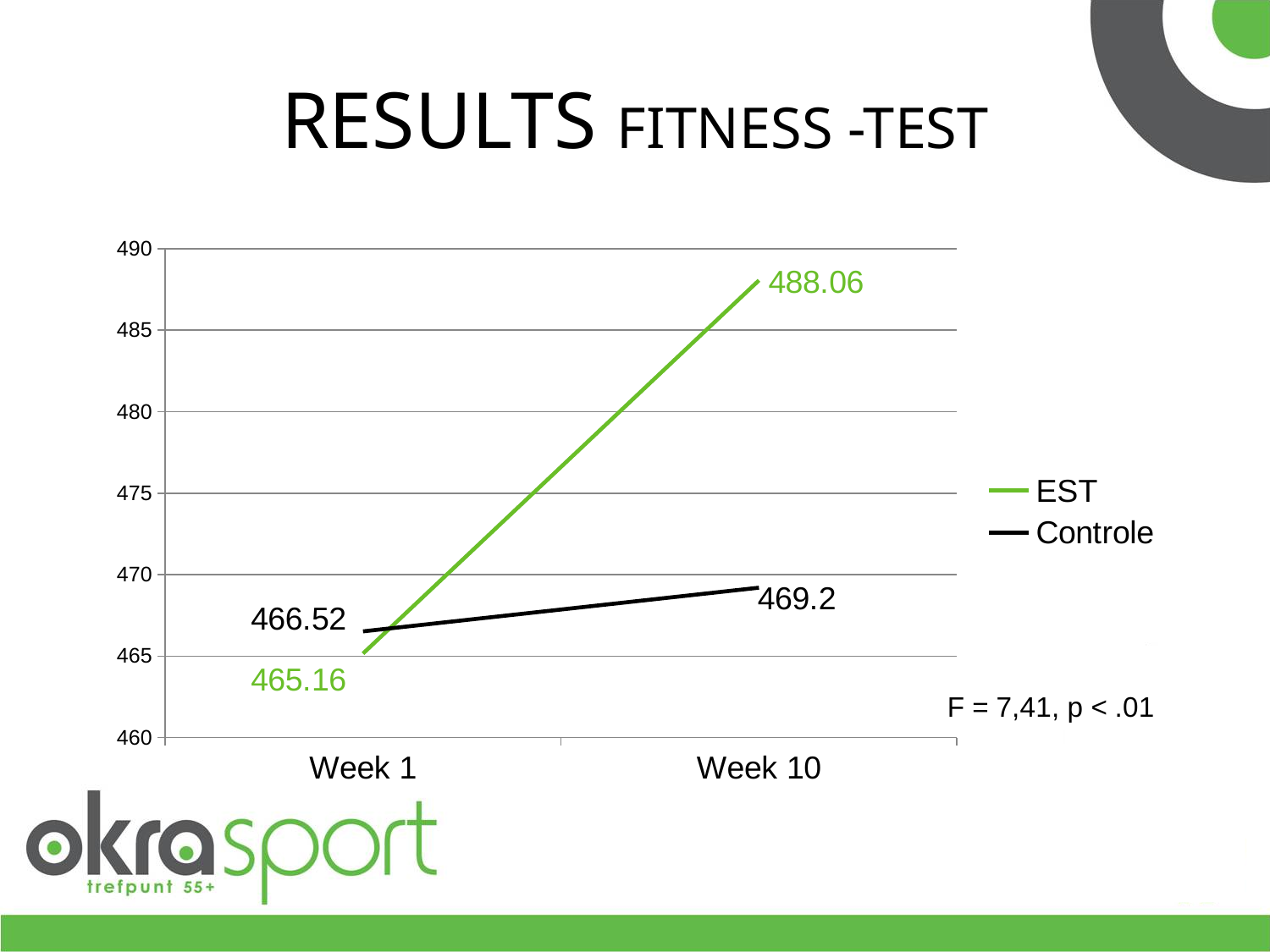
How many points on the x axis are shown? 2 What is the value for EST at Week 10? 488.06 What is the value for Controle at Week 10? 469.2 What is the difference between the EST and Controle values at Week 10? 18.86 What colour is the EST line? green Does the EST series rise or fall from Week 1 to Week 10? rise What is the value for Controle at Week 1? 466.52 What is the difference between the EST values at Week 10 and Week 1? 22.9 What kind of chart is shown on the slide? line chart Which series has the higher value at Week 10, EST or Controle? EST How many series does the legend list? 2 What is the value for EST at Week 1? 465.16